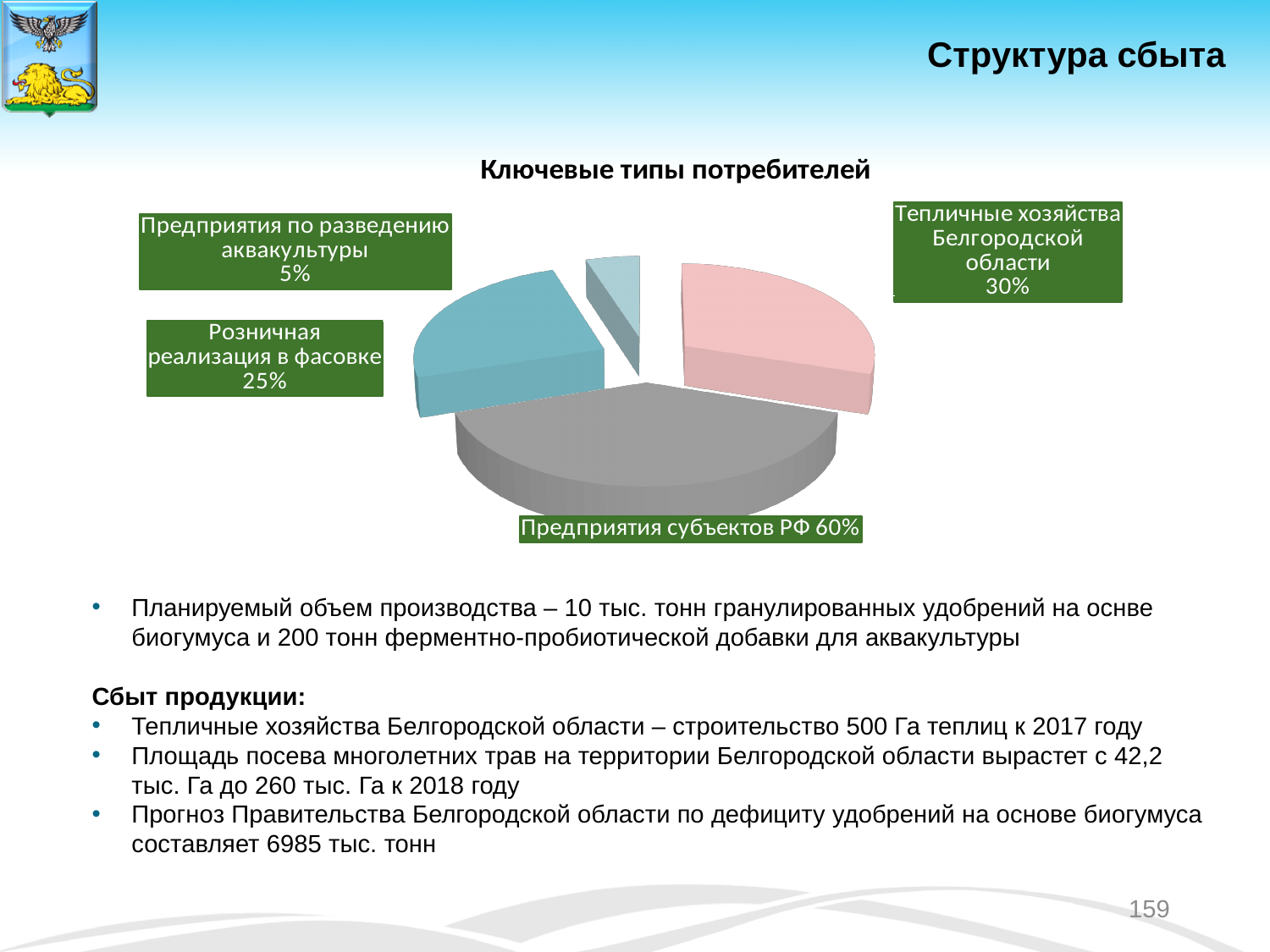
What percentage is shown for Предприятия по разведению аквакультуры? 5% What colour is the slice for Предприятия субъектов РФ? Grey Which category has the largest slice of the pie? Предприятия субъектов РФ What percentage is shown for Предприятия субъектов РФ? 60% What is the difference in percentage points between Предприятия субъектов РФ and Тепличные хозяйства Белгородской области? 30 How many slices does the pie chart have? 4 What percentage is shown for Тепличные хозяйства Белгородской области? 30% Which category has the smallest slice of the pie? Предприятия по разведению аквакультуры Which is larger: Тепличные хозяйства Белгородской области or Розничная реализация в фасовке? Тепличные хозяйства Белгородской области What is the title of the chart? Ключевые типы потребителей What percentage is shown for Розничная реализация в фасовке? 25% What type of chart is shown on the slide? Pie chart